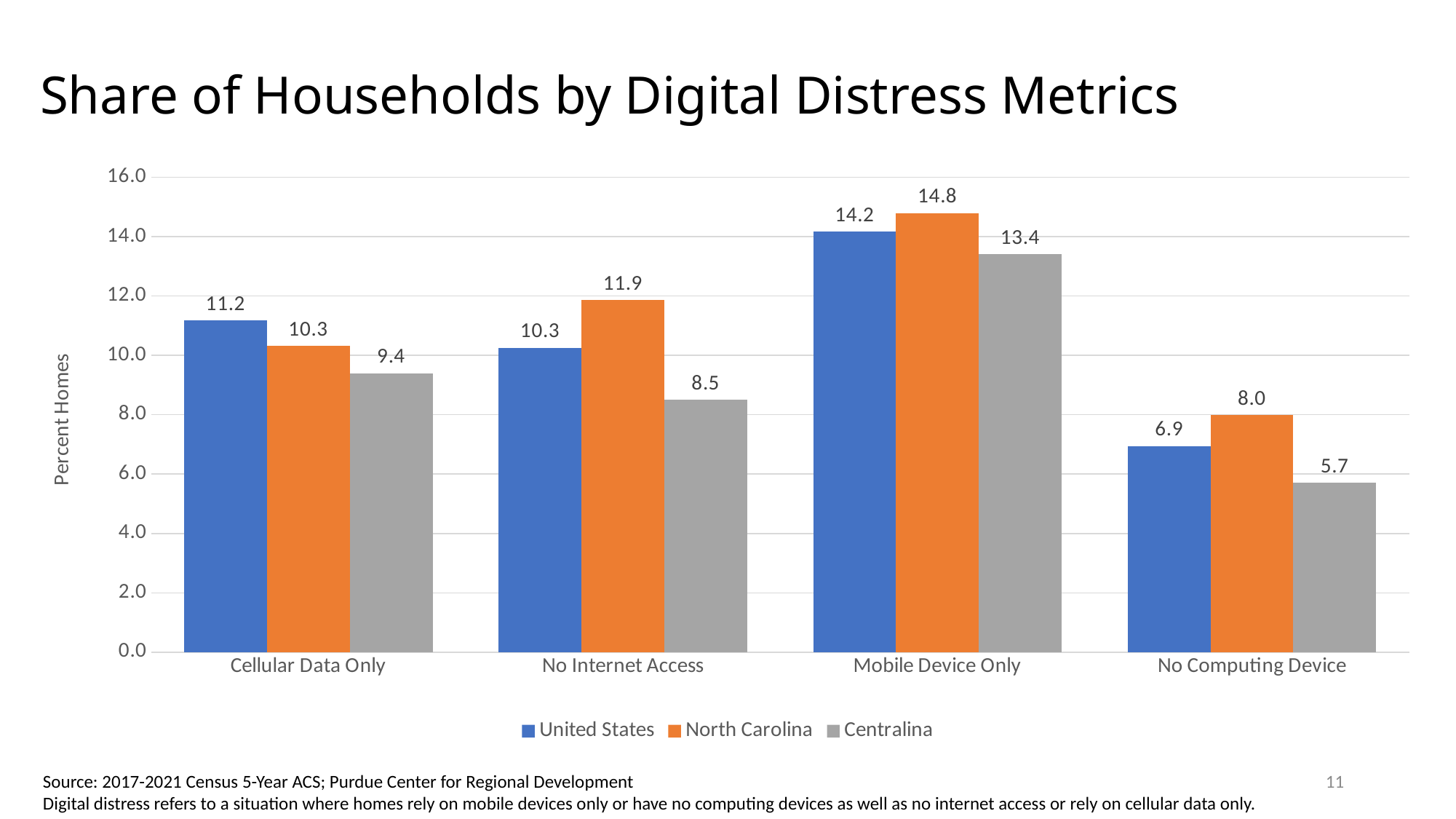
What is the value for North Carolina in the Mobile Device Only category? 14.8 How many series does the legend list? 3 Which is larger in the Cellular Data Only category: United States or North Carolina? United States Is the value for North Carolina in the No Internet Access category greater or less than 10.0? greater Which category has the highest value for Centralina? Mobile Device Only What is the difference between North Carolina and Centralina in the No Computing Device category? 2.3 What is the label of the y axis? Percent Homes What is the value for United States in the Cellular Data Only category? 11.2 How many categories are shown on the x axis? 4 What is the value for Centralina in the No Internet Access category? 8.5 What kind of chart is shown on the slide? Bar chart Which category has the lowest value for United States? No Computing Device